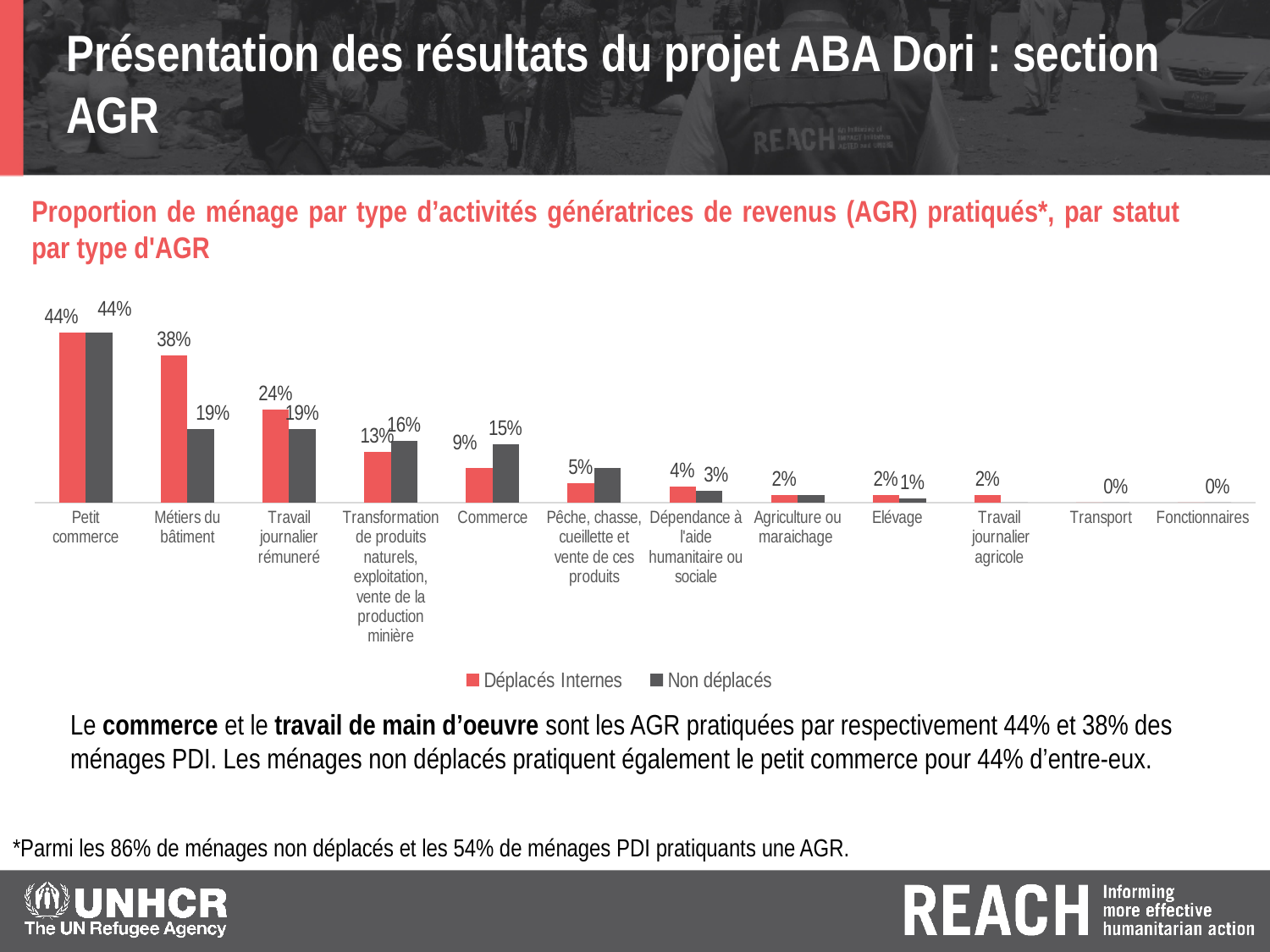
What kind of chart is shown on the slide? Bar chart For the Transformation de produits naturels category, which series has the larger value, Déplacés Internes or Non déplacés? Non déplacés Do the Déplacés Internes values generally rise or fall from left to right across the categories? Fall Which category has the highest value for Déplacés Internes? Petit commerce What is the difference between the Déplacés Internes and Non déplacés values for Métiers du bâtiment? 19% Which colour represents the Non déplacés series in the chart? Grey For Travail journalier rémuneré, which series has the larger value, Déplacés Internes or Non déplacés? Déplacés Internes What is the value for Non déplacés households in the Commerce category? 15% How many series does the legend list? 2 What is the value for Déplacés Internes in the Travail journalier rémuneré category? 24% What is the value for Déplacés Internes in the Elévage category? 2% What percentage of Déplacés Internes households practise Métiers du bâtiment? 38%